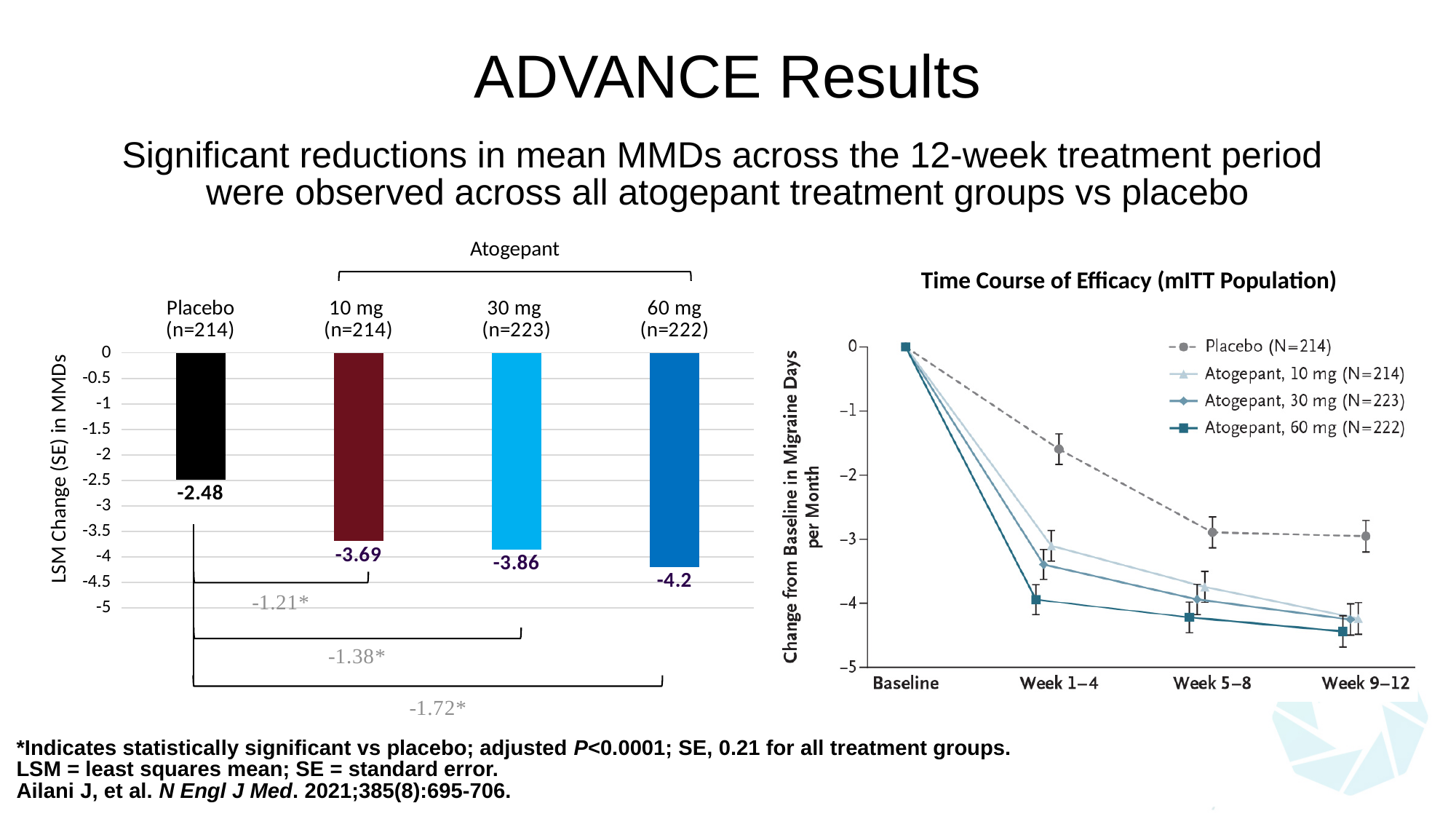
In the bar chart on the left, which group shows the smallest reduction in MMDs? Placebo In the bar chart on the left, what is the LSM change in MMDs for the atogepant 60 mg group? -4.2 In the 'Time Course of Efficacy (mITT Population)' chart, how many series does the legend list? 4 In the bar chart on the left, what is the difference between the 60 mg group and placebo, as labelled on the slide? -1.72* In the bar chart on the left, what is the LSM change in MMDs for the placebo group? -2.48 In the bar chart on the left, what is the LSM change in MMDs for the atogepant 30 mg group? -3.86 In the bar chart on the left, which group shows the largest reduction in MMDs? 60 mg In the 'Time Course of Efficacy (mITT Population)' chart, is the value for Atogepant 60 mg at Week 1–4 greater or less than -3? less What kind of chart is the chart on the left of the slide? Bar chart In the bar chart on the left, how many treatment groups are plotted? 4 In the bar chart on the left, what is the difference between the 10 mg group and placebo, as labelled on the slide? -1.21* In the 'Time Course of Efficacy (mITT Population)' chart, do the values for Placebo rise or fall from Baseline to Week 9–12? Fall